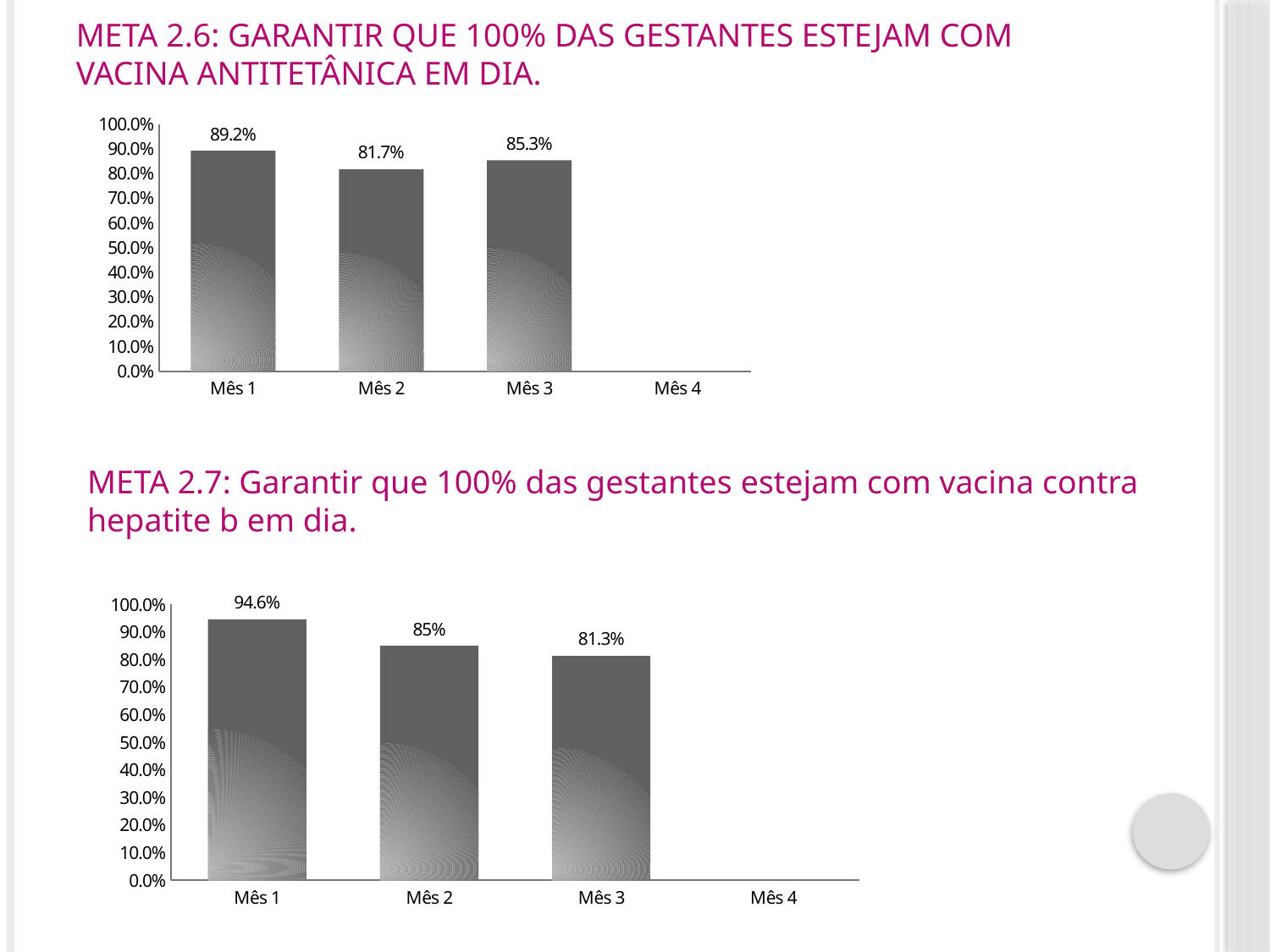
In the bottom chart (META 2.7), what is the difference between the values for Mês 2 and Mês 3? 3.7% What kind of chart is the bottom chart (META 2.7)? bar chart In the top chart (META 2.6), what is the value for Mês 2? 81.7% In the top chart (META 2.6), which month has the highest value? Mês 1 In the top chart (META 2.6), how many bars are plotted? 3 In the top chart (META 2.6), what is the difference between the values for Mês 1 and Mês 2? 7.5% In the bottom chart (META 2.7), what is the value for Mês 3? 81.3% In the top chart (META 2.6), which month with a plotted bar has the lowest value? Mês 2 In the bottom chart (META 2.7), which month has the highest value? Mês 1 In the bottom chart (META 2.7), do the values rise or fall from Mês 1 to Mês 3? fall In the bottom chart (META 2.7), what is the value for Mês 1? 94.6% In the top chart (META 2.6), what is the value for Mês 1? 89.2%